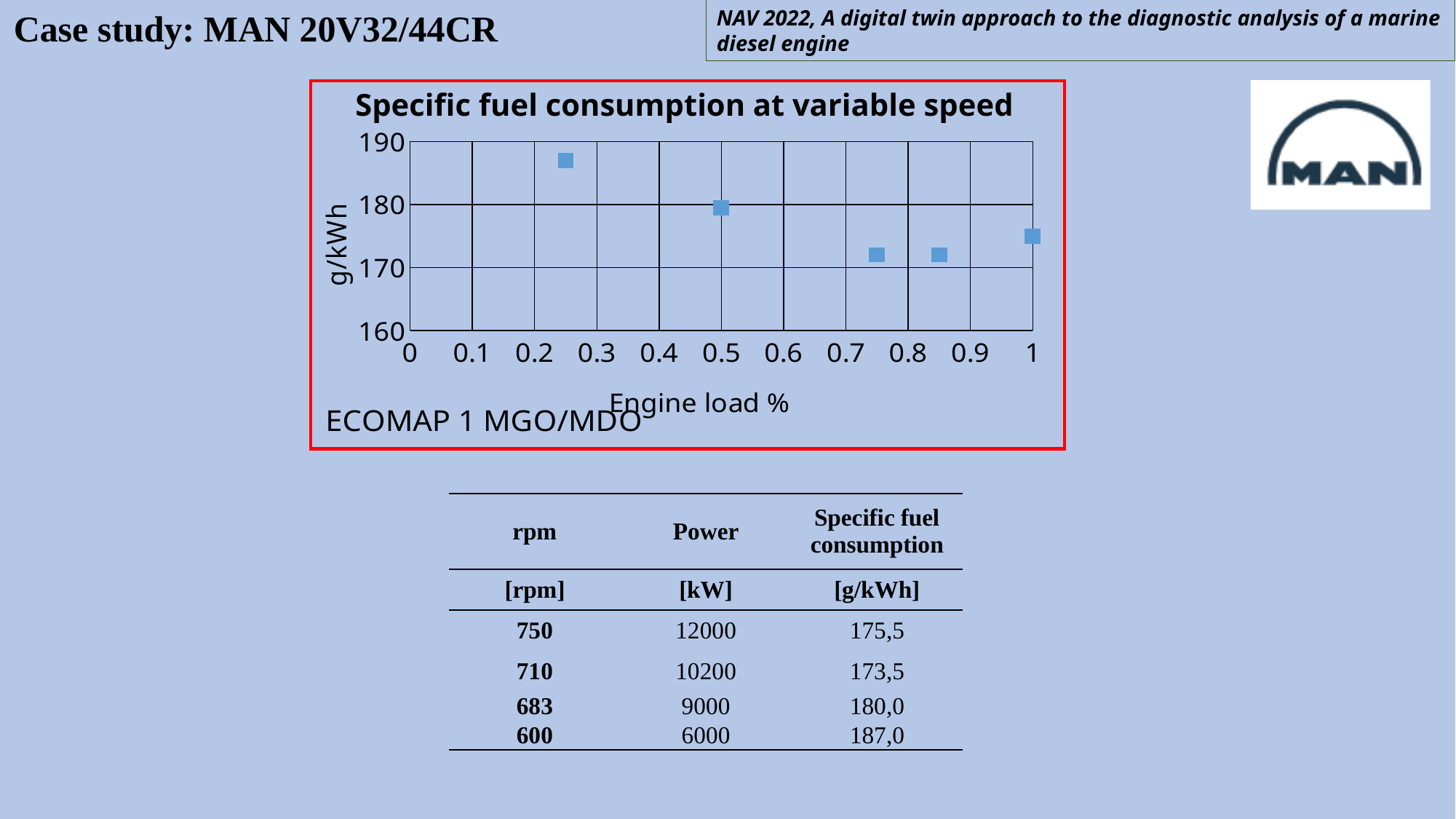
What is the title of the chart? Specific fuel consumption at variable speed Is the value at engine load 1 greater or less than 180? less Which has the higher specific fuel consumption: engine load 0.25 or engine load 1? engine load 0.25 Is the value at engine load 0.25 greater or less than 180? greater Is the value at engine load 0.75 greater or less than 170? greater How many data points are plotted in the chart? 5 Which has the higher specific fuel consumption: engine load 0.5 or engine load 0.75? engine load 0.5 At which engine load is the specific fuel consumption highest? 0.25 What is the label of the y axis of the chart? g/kWh What kind of chart is shown on the slide? scatter chart Do the plotted values rise or fall as engine load increases from 0.25 to 0.75? fall